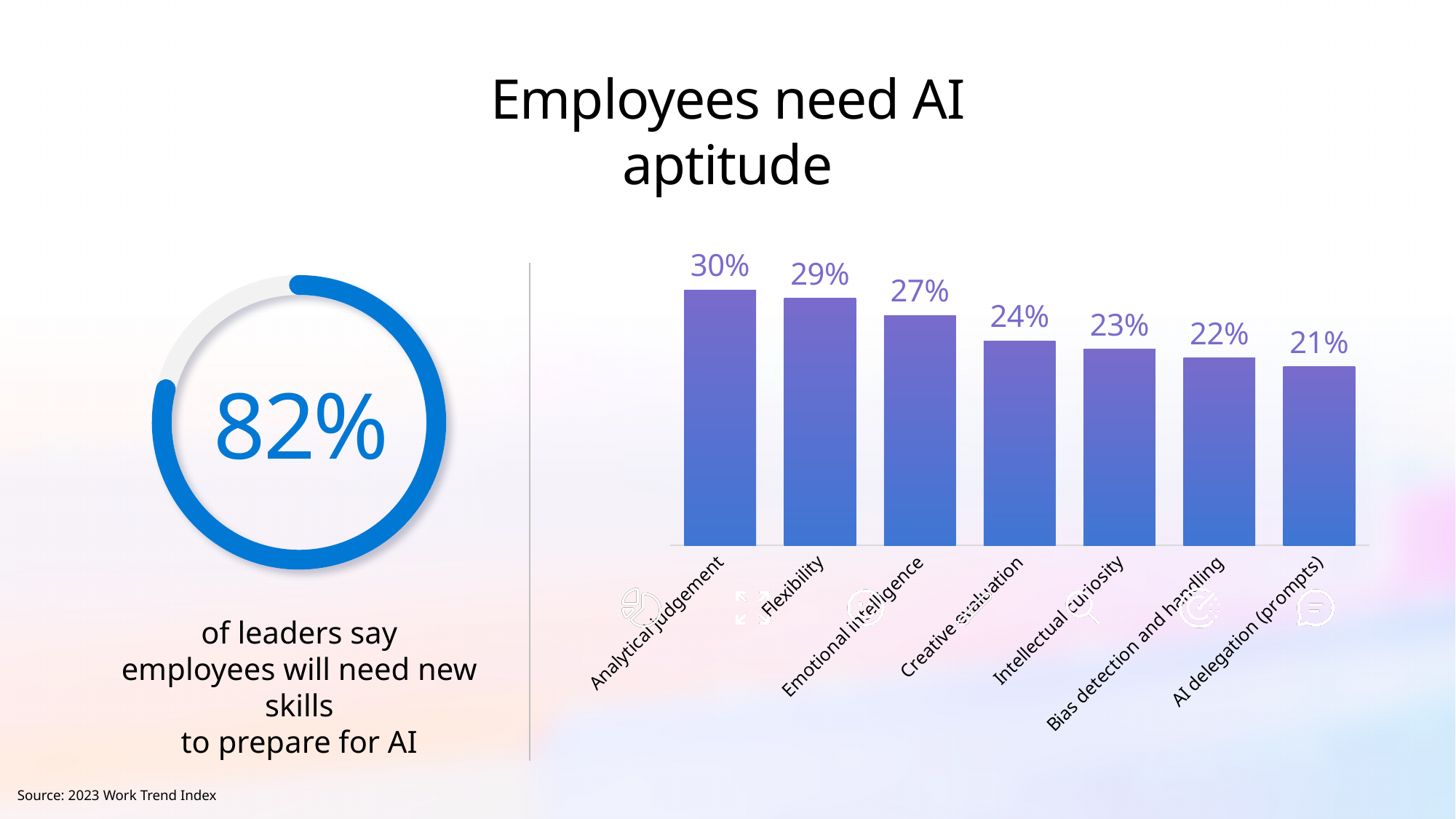
What kind of chart is shown on the right side of the slide? Bar chart In the bar chart on the right, which is larger: the value for Intellectual curiosity or the value for Creative evaluation? Creative evaluation In the bar chart on the right, which category has the highest value? Analytical judgement How many categories are shown in the bar chart on the right? 7 In the bar chart on the right, what is the value for Emotional intelligence? 27% In the bar chart on the right, what is the value for Analytical judgement? 30% In the bar chart on the right, what is the value for Bias detection and handling? 22% In the bar chart on the right, what is the value for AI delegation (prompts)? 21% In the bar chart on the right, what is the difference between the values for Analytical judgement and AI delegation (prompts)? 9% In the bar chart on the right, what is the difference between the values for Flexibility and Creative evaluation? 5% In the bar chart on the right, do the values rise or fall from left to right? Fall In the bar chart on the right, which category has the lowest value? AI delegation (prompts)